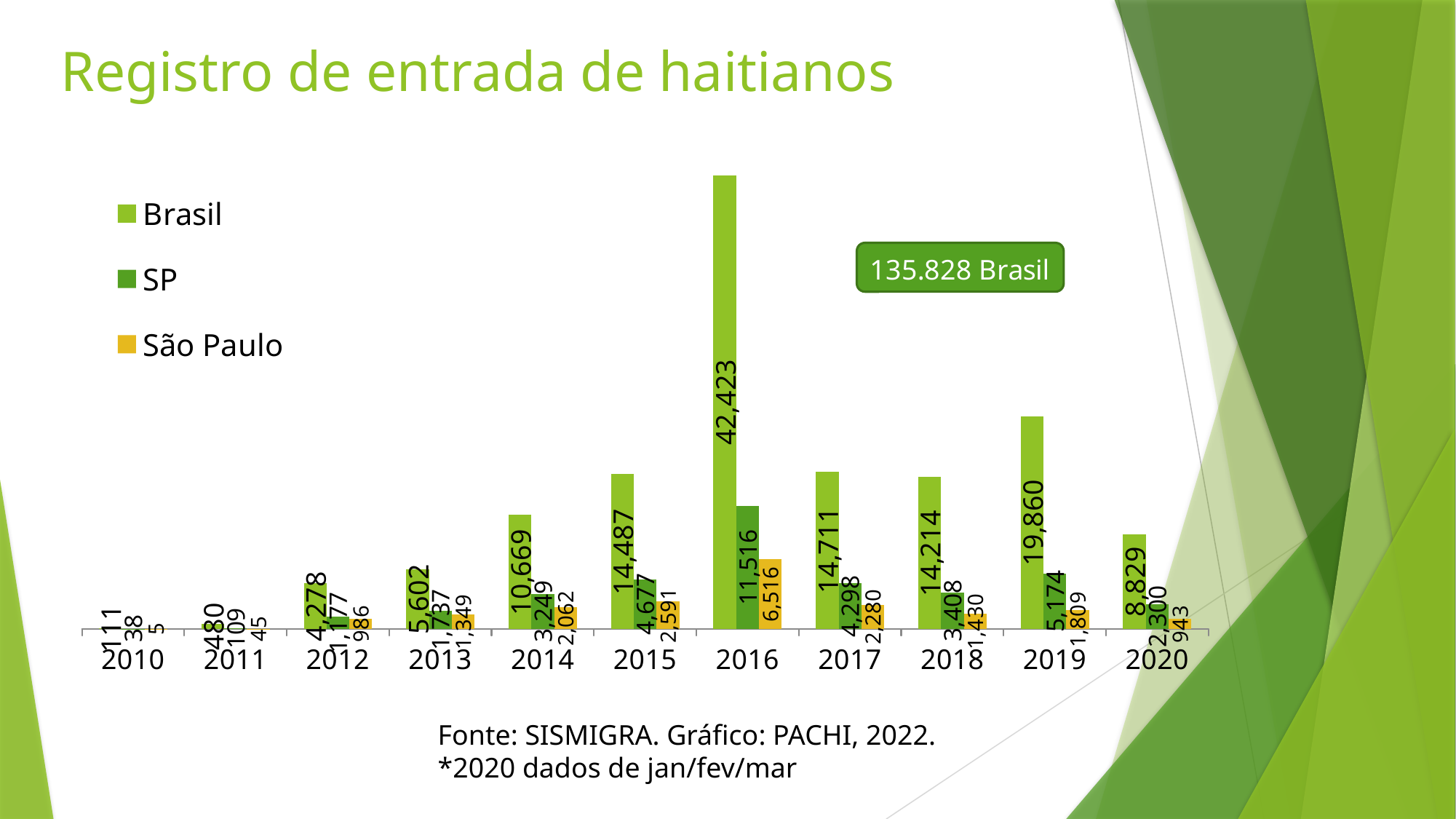
Which is larger, the Brasil value for 2015 or for 2017? 2017 What is the SP value for 2016? 11,516 What is the São Paulo value for 2016? 6,516 What is the difference between the Brasil values for 2016 and 2019? 22,563 What is the Brasil value for 2014? 10,669 What is the Brasil value for 2019? 19,860 What kind of chart is shown on the slide? Bar chart What is the Brasil value for 2016? 42,423 Which year has the highest Brasil value? 2016 Which year has the lowest Brasil value? 2010 How many series does the legend list? 3 How many years are shown on the x axis? 11